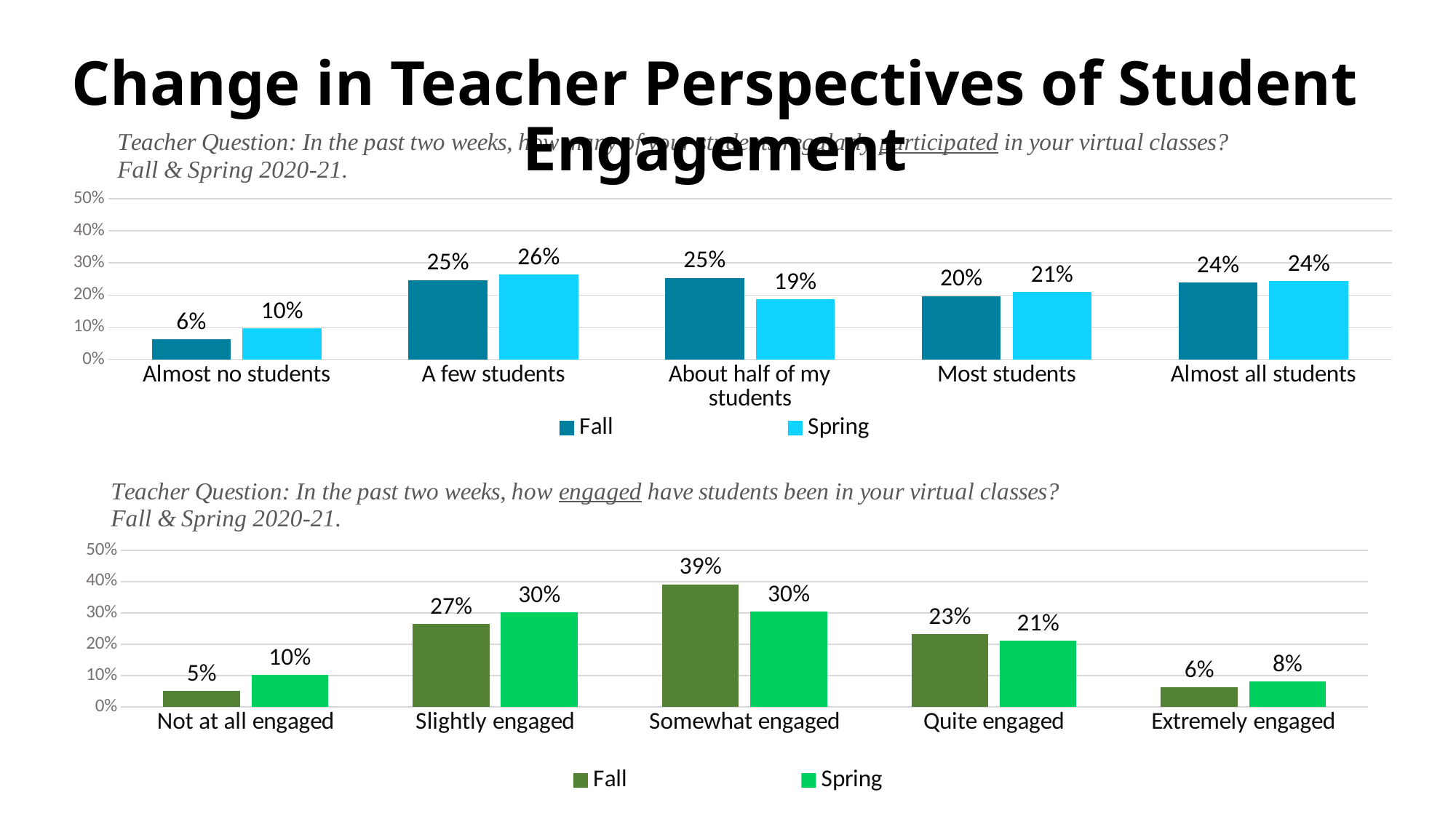
In the top chart (participation), which category has the lowest Fall value? Almost no students In the bottom chart (engagement), what is the Fall value for 'Somewhat engaged'? 39% In the bottom chart (engagement), what is the difference between the Fall and Spring values for 'Somewhat engaged'? 9% In the top chart (participation), how many categories are shown on the x axis? 5 In the top chart (participation), what is the difference between the Spring and Fall values for 'Almost no students'? 4% In the bottom chart (engagement), which category has the lowest Fall value? Not at all engaged In the top chart (participation), is the Fall value for 'About half of my students' larger or smaller than the Spring value? larger In the top chart (participation), what is the Spring value for 'About half of my students'? 19% In the bottom chart (engagement), how many series does the legend list? 2 In the top chart (participation), what is the Fall value for 'Almost no students'? 6% What type of chart is the bottom chart (engagement)? Bar chart In the bottom chart (engagement), which category has the highest Spring value? Slightly engaged and Somewhat engaged (both 30%)